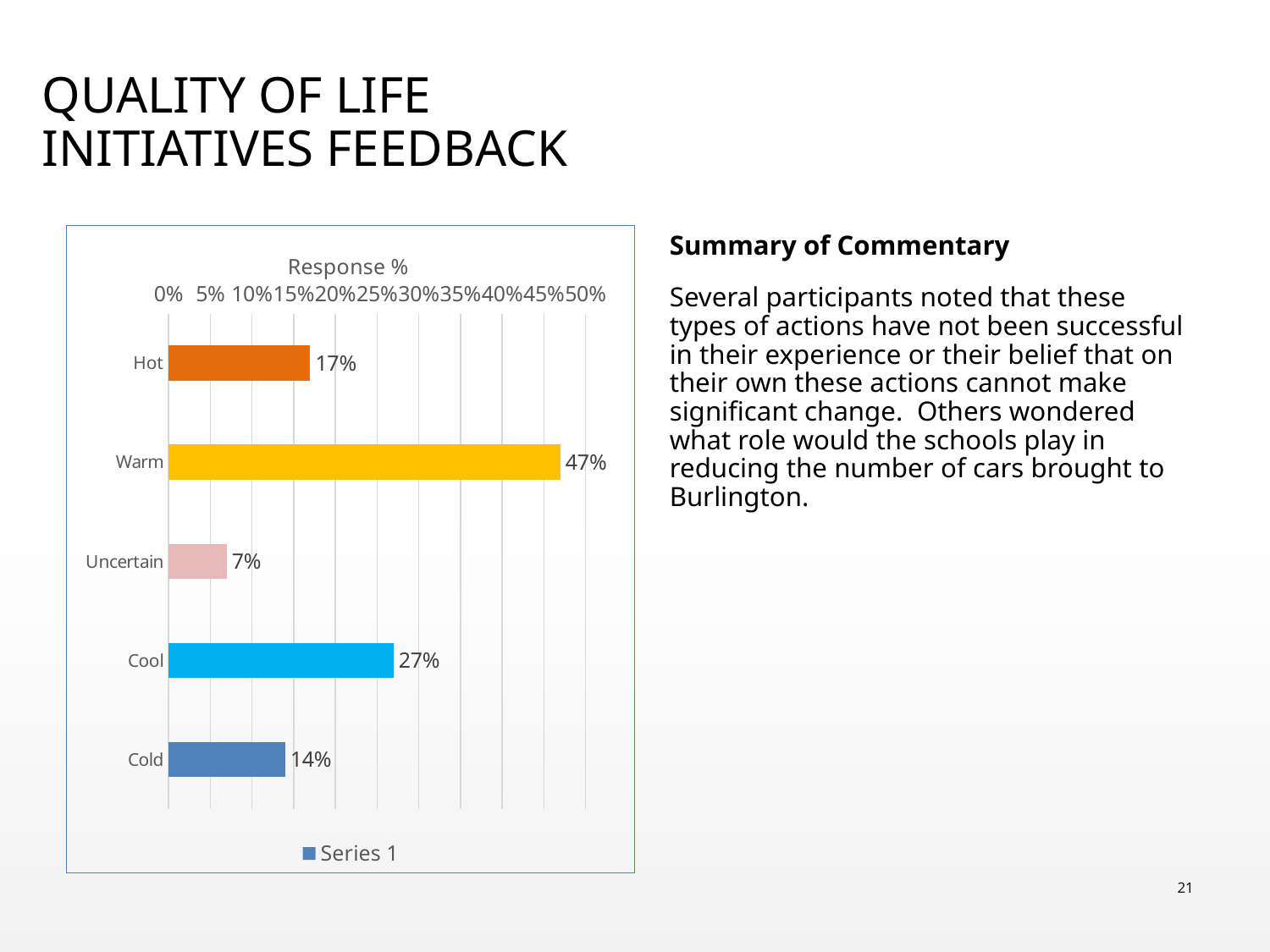
What is the title of the chart? Response % What is the value for Uncertain? 7% What is the difference between the values for Hot and Cold? 3% What is the difference between the values for Warm and Cool? 20% Which category has the highest value? Warm What is the value for Warm? 47% What is the value for Cold? 14% Which is larger, the value for Cool or the value for Hot? Cool What kind of chart is shown on the slide? bar chart Is the value for Warm greater or less than 40%? greater Which category has the lowest value? Uncertain How many categories are shown in the chart? 5